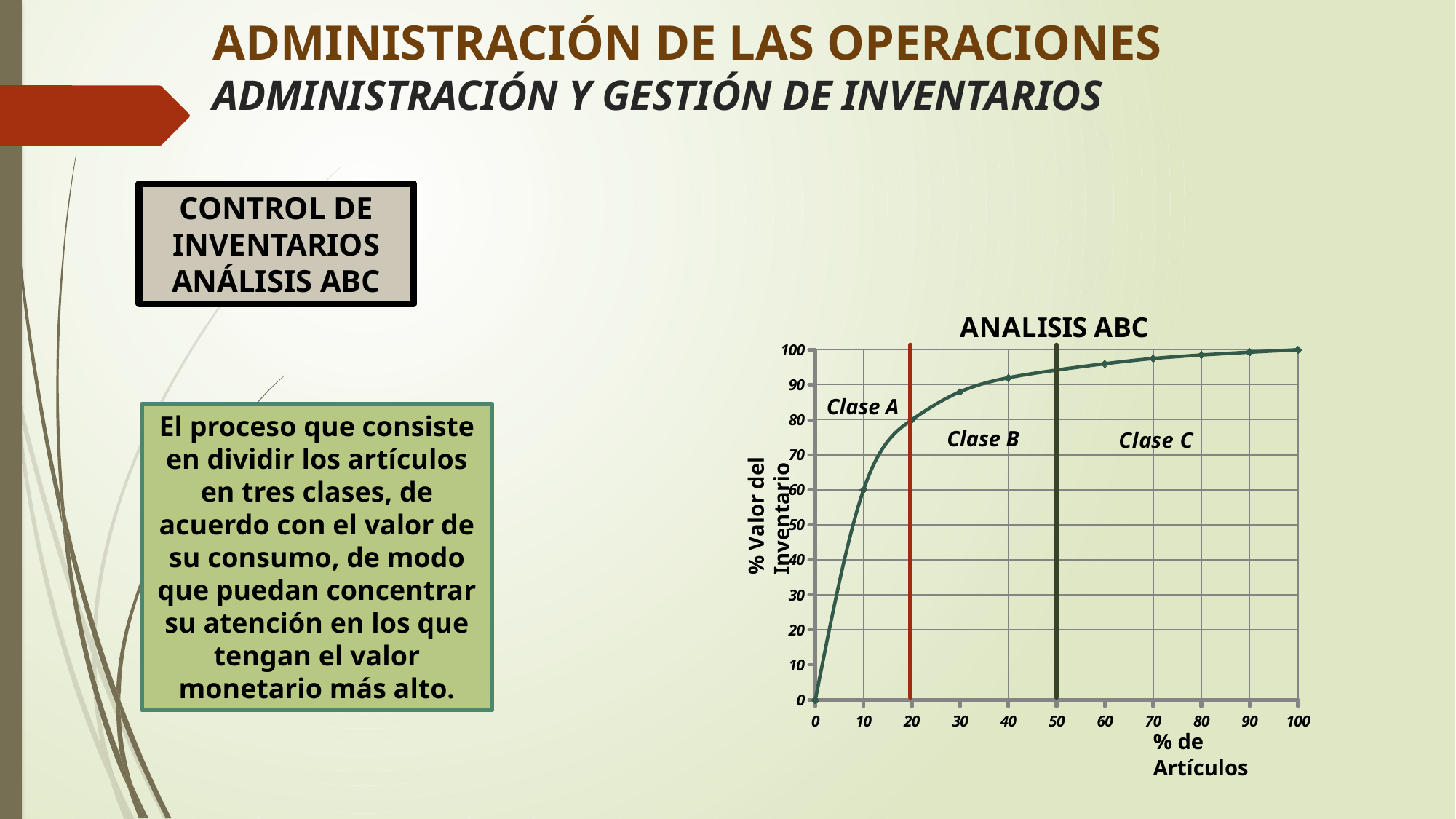
Is the % Valor del Inventario at 30% de Artículos greater or less than 80? greater What is the % Valor del Inventario when % de Artículos is 10? 60 How many data points are plotted on the line? 11 At which % de Artículos is the % Valor del Inventario lowest? 0 What is the % Valor del Inventario when % de Artículos is 20? 80 What is the % Valor del Inventario when % de Artículos is 100? 100 What is the difference in % Valor del Inventario between 20% and 10% de Artículos? 20 What kind of chart is shown on the slide? line chart What is the title of the chart? ANALISIS ABC Do the values rise or fall as % de Artículos increases along the x axis? rise At which % de Artículos is the % Valor del Inventario highest? 100 Is the % Valor del Inventario at 60% de Artículos greater or less than 90? greater